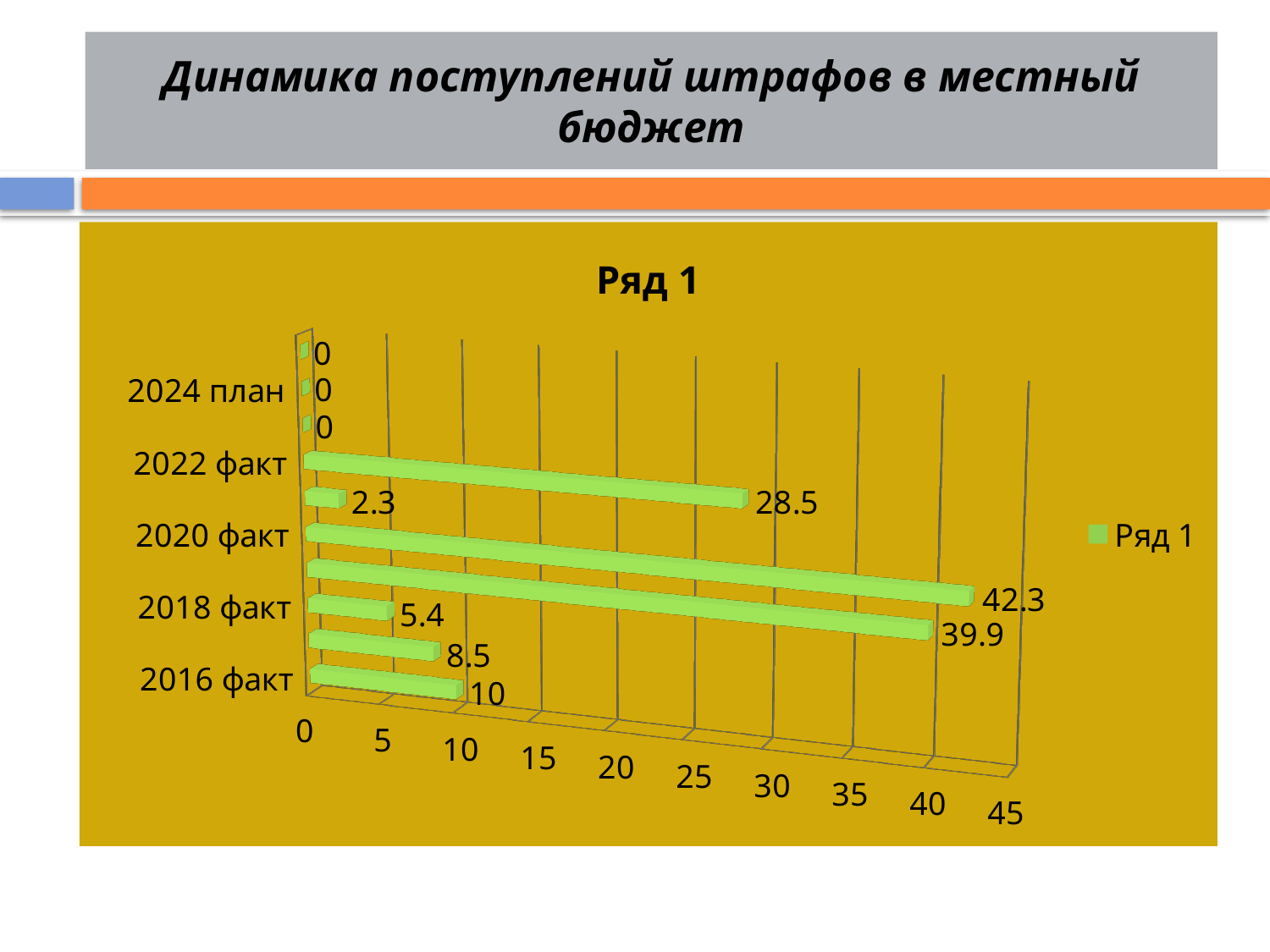
What is the difference between the values for 2020 факт and 2022 факт? 13.8 Is the value for 2020 факт greater or less than 40? greater What kind of chart is shown on the slide? bar chart Which is larger, the value for 2022 факт or the value for 2016 факт? 2022 факт Which labelled category has the lowest value? 2024 план How many series does the legend list? 1 What is the value for 2024 план? 0 What is the value for 2020 факт? 42.3 What is the title of the chart? Ряд 1 What is the value for 2022 факт? 28.5 Which labelled category has the highest value? 2020 факт What is the value for 2016 факт? 10